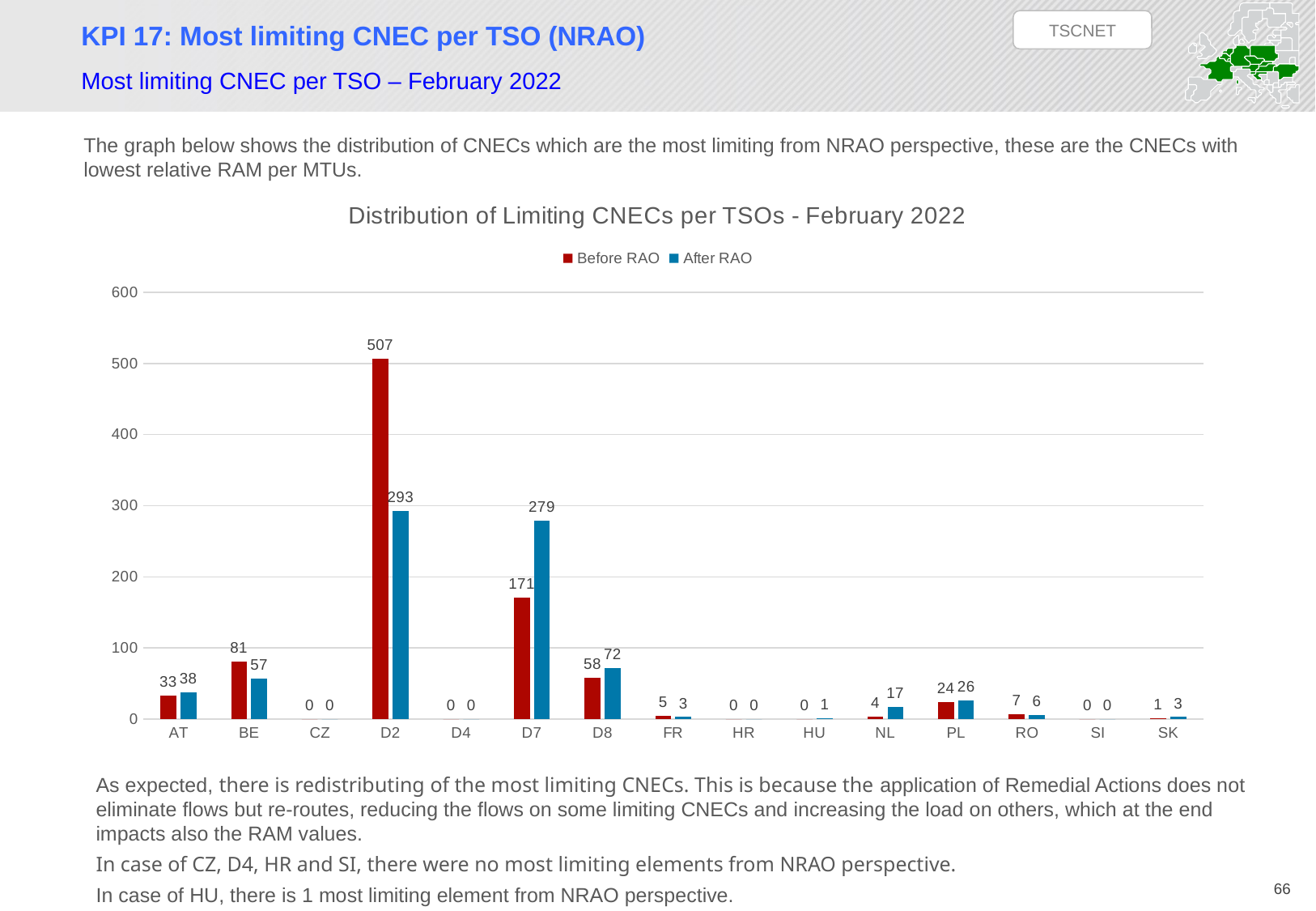
Which is larger for D8, the Before RAO value or the After RAO value? After RAO What is the title of the chart? Distribution of Limiting CNECs per TSOs - February 2022 What is the difference between the Before RAO and After RAO values for D2? 214 How many TSO categories are shown on the x axis? 15 What is the After RAO value for D7? 279 What kind of chart is shown on the slide? bar chart What is the Before RAO value for D2? 507 How many series does the legend list? 2 What is the After RAO value for NL? 17 Which TSO has the highest Before RAO value? D2 What is the After RAO value for BE? 57 Is the Before RAO value for D7 greater or less than 200? less